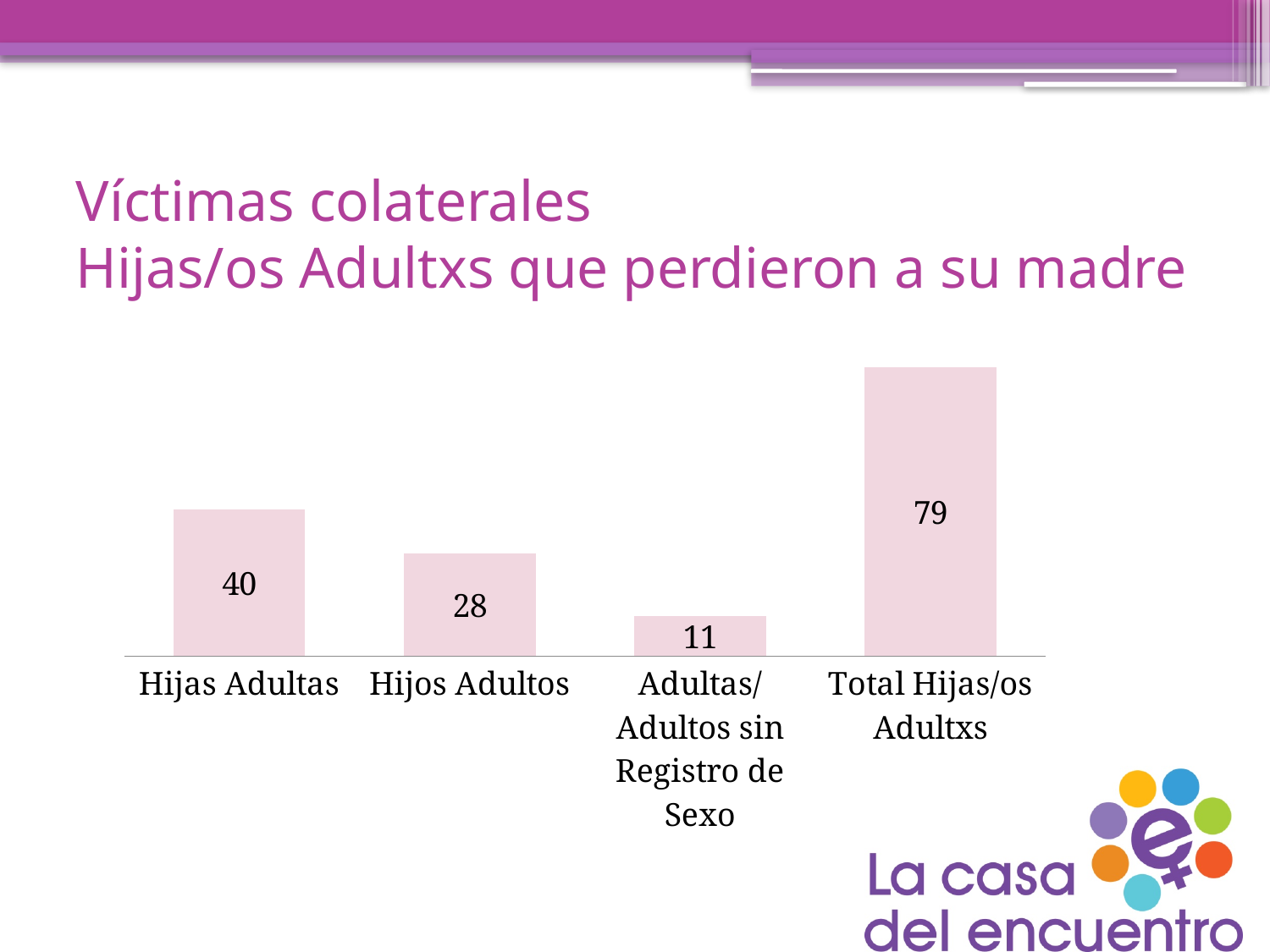
What is the title of the slide containing the chart? Víctimas colaterales Hijas/os Adultxs que perdieron a su madre What is the difference between the values for Hijas Adultas and Hijos Adultos? 12 What is the value for Hijas Adultas? 40 Which category has the lowest value? Adultas/Adultos sin Registro de Sexo Which is larger, the value for Hijas Adultas or the value for Hijos Adultos? Hijas Adultas Which category has the highest value? Total Hijas/os Adultxs What is the value for Hijos Adultos? 28 What is the value for Total Hijas/os Adultxs? 79 What kind of chart is shown on the slide? Bar chart What is the value for Adultas/Adultos sin Registro de Sexo? 11 How many categories are shown in the chart? 4 What is the difference between the value for Total Hijas/os Adultxs and the value for Adultas/Adultos sin Registro de Sexo? 68